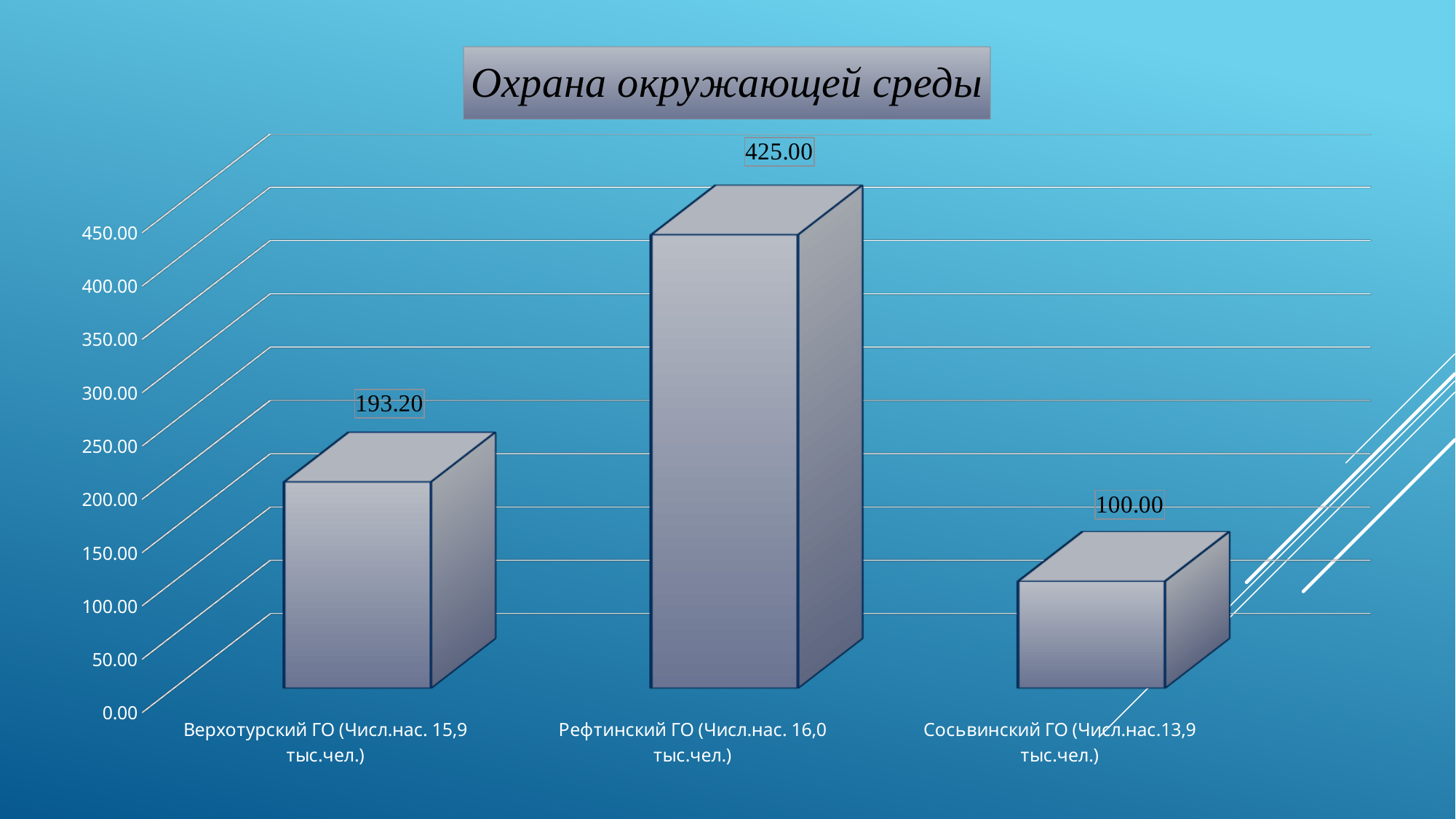
What is the value for Рефтинский ГО? 425.00 Is the value for Рефтинский ГО greater or less than 400? greater What kind of chart is shown on the slide? bar chart Which category has the highest value? Рефтинский ГО What is the title of the chart? Охрана окружающей среды How many categories are shown in the chart? 3 What is the value for Верхотурский ГО? 193.20 Which is larger, the value for Верхотурский ГО or the value for Сосьвинский ГО? Верхотурский ГО What is the difference between the values for Рефтинский ГО and Верхотурский ГО? 231.80 Which category has the lowest value? Сосьвинский ГО What is the value for Сосьвинский ГО? 100.00 What is the difference between the values for Верхотурский ГО and Сосьвинский ГО? 93.20